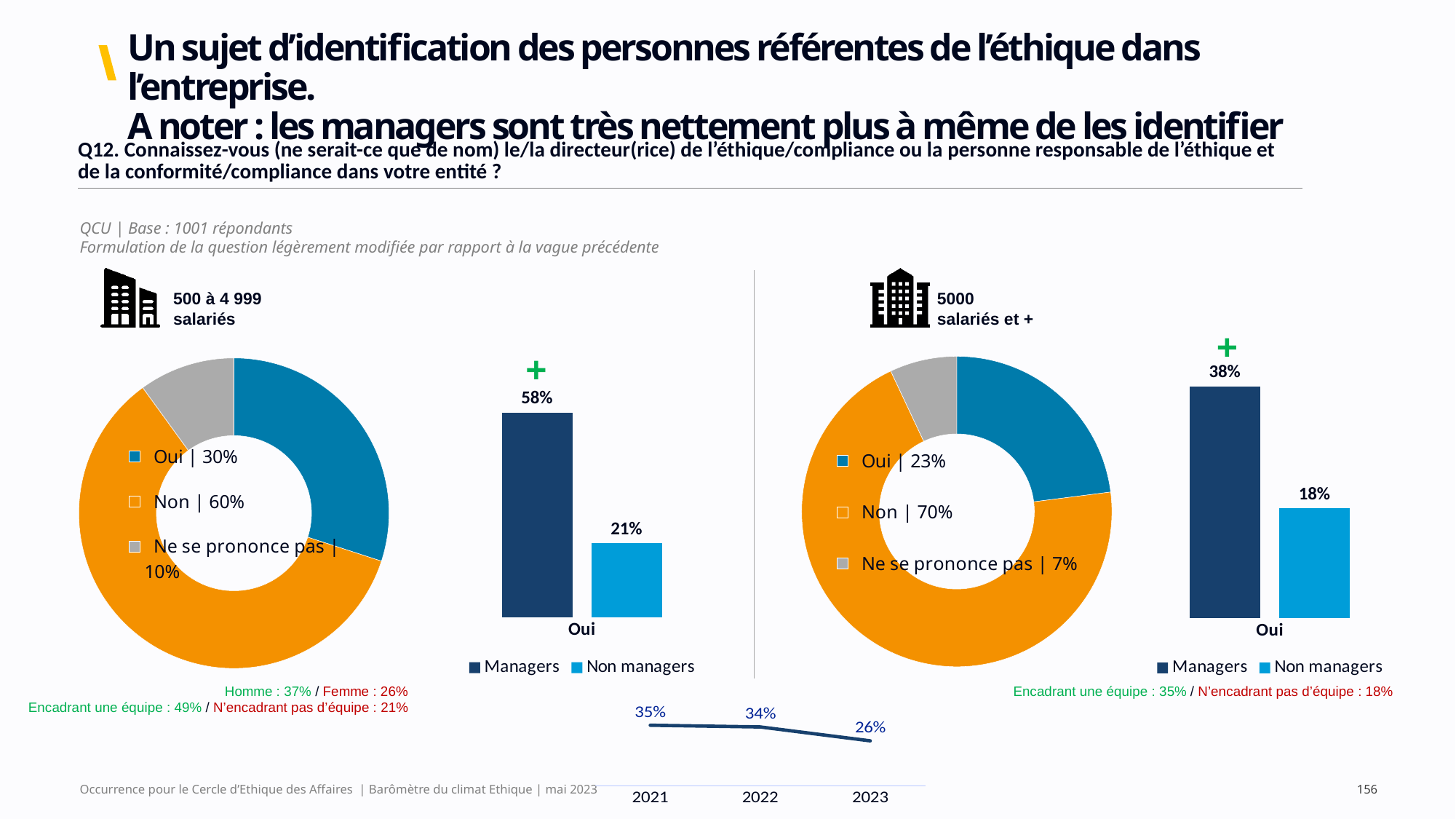
How many series does the legend of the bar chart for '5000 salariés et +' list? 2 In the bar chart for '5000 salariés et +', what is the value for Non managers? 18% In the bar chart for '5000 salariés et +', which is larger, Managers or Non managers? Managers In the donut chart for '500 à 4 999 salariés', what share is 'Non'? 60% What kind of chart is used to show the 'Oui | 30%', 'Non | 60%', 'Ne se prononce pas | 10%' breakdown? donut chart In the bar chart for '500 à 4 999 salariés', what is the value for Managers? 58% In the donut chart for '500 à 4 999 salariés', which category has the largest share? Non In the line chart at the bottom of the slide, do the values rise or fall from 2021 to 2023? fall In the bar chart for '500 à 4 999 salariés', what is the difference between Managers and Non managers? 37% In the donut chart for '5000 salariés et +', which category has the smallest share? Ne se prononce pas In the donut chart for '5000 salariés et +', what share is 'Oui'? 23% In the line chart at the bottom of the slide, what is the value for 2022? 34%